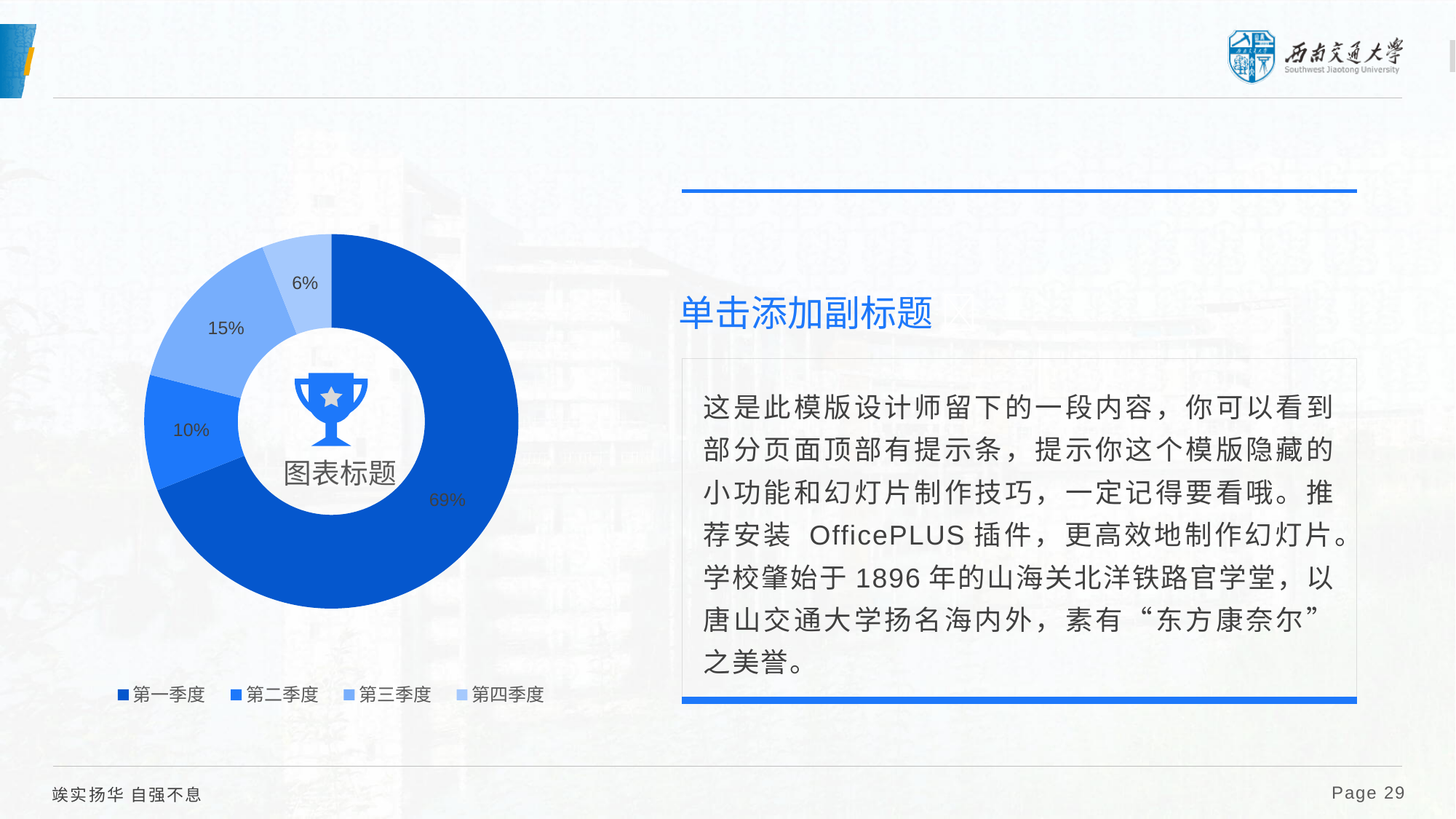
Which category has the smallest share in the chart? 第四季度 What is the value for 第三季度 in the chart? 15% What is the value for 第四季度 in the chart? 6% What is the value for 第二季度 in the chart? 10% How many entries does the chart legend list? 4 What is the title shown in the centre of the chart? 图表标题 Which is larger, the value for 第三季度 or the value for 第四季度? 第三季度 What is the value for 第一季度 in the chart? 69% What is the difference between the values for 第三季度 and 第二季度? 5% What kind of chart is shown on the slide? doughnut chart Which category has the largest share in the chart? 第一季度 How many categories does the chart show? 4